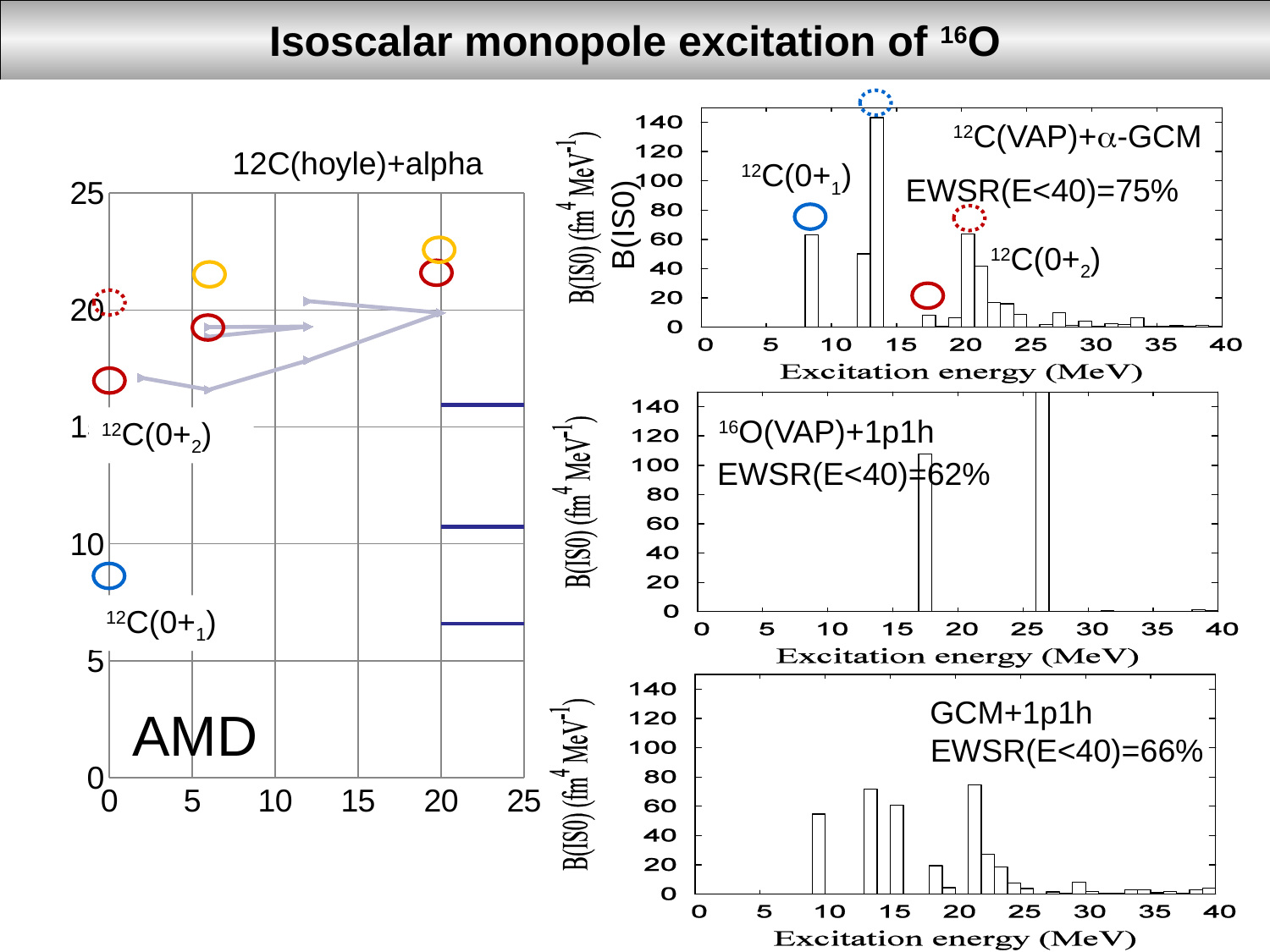
What kind of chart is the bottom-right chart titled GCM+1p1h? bar chart In the bottom-right chart (GCM+1p1h), is the bar near 13 MeV greater or less than 60? greater In the middle-right chart (16O(VAP)+1p1h), is the bar near 26 MeV greater or less than 140? greater In the top-right chart (12C(VAP)+α-GCM), is the bar near 12 MeV greater or less than 60? less What is the x-axis label of the three bar charts on the right? Excitation energy (MeV) In the middle-right chart (16O(VAP)+1p1h), which bar is taller: the one near 17 MeV or the one near 26 MeV? the one near 26 MeV What kind of chart is the top-right chart titled 12C(VAP)+α-GCM? bar chart What EWSR(E<40) value is shown on the top-right chart (12C(VAP)+α-GCM)? 75%